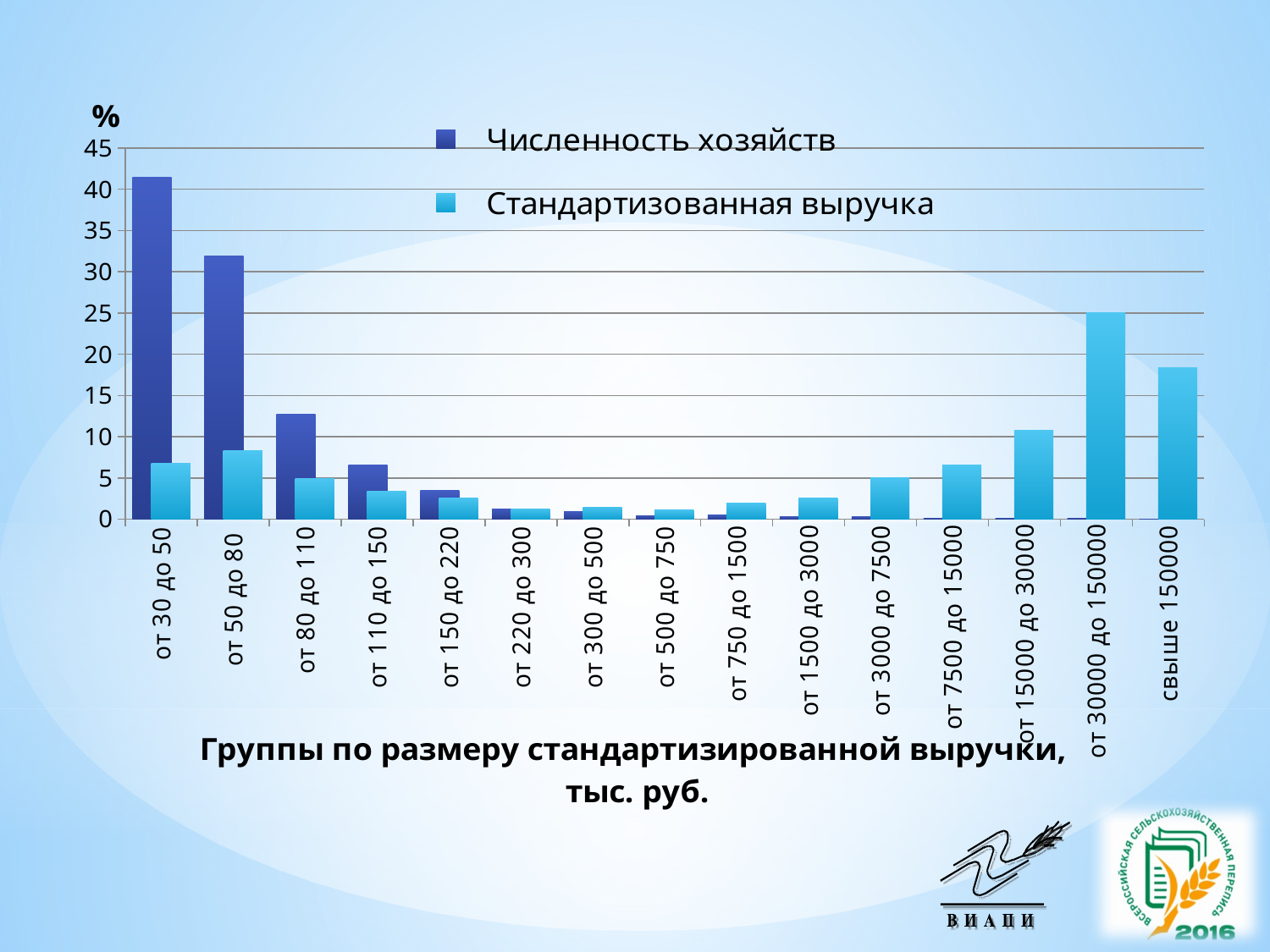
Is the value of Численность хозяйств for the group от 30 до 50 greater or less than 35? greater Which group has the highest value for Численность хозяйств? от 30 до 50 Is the value of Стандартизованная выручка for the group свыше 150000 greater or less than 20? less Is the value of Численность хозяйств for the group от 50 до 80 greater or less than 30? greater Does the value of Численность хозяйств generally rise or fall moving from left to right along the x axis? fall How many category groups are shown along the x axis? 15 What is the title of the x axis? Группы по размеру стандартизированной выручки, тыс. руб. For the group от 30 до 50, which series has the larger value: Численность хозяйств or Стандартизованная выручка? Численность хозяйств What kind of chart is shown on the slide? bar chart How many series does the legend list? 2 Which group has the highest value for Стандартизованная выручка? от 30000 до 150000